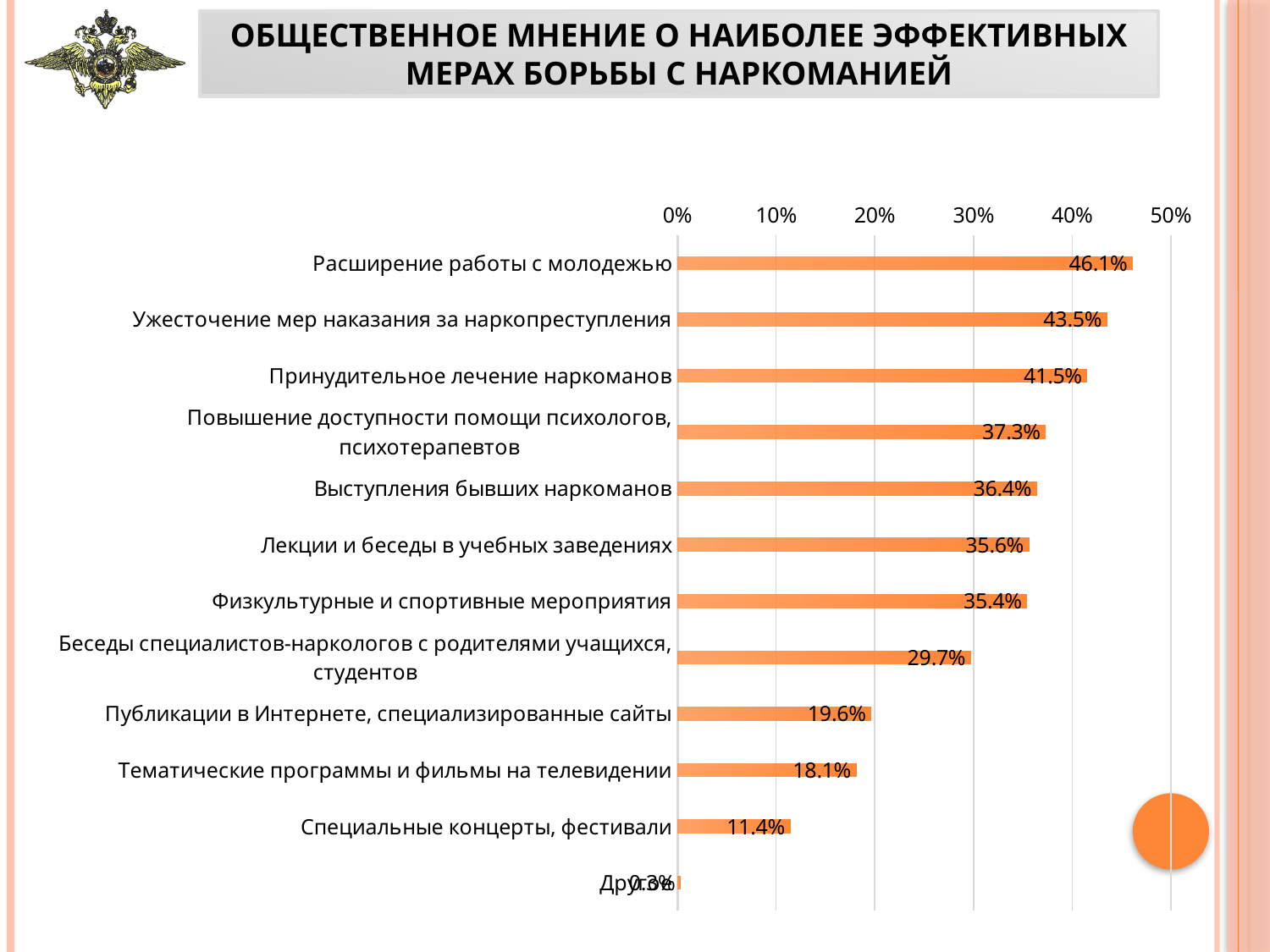
Which is larger: the value for "Выступления бывших наркоманов" or for "Беседы специалистов-наркологов с родителями учащихся, студентов"? Выступления бывших наркоманов Is the value for "Принудительное лечение наркоманов" greater or less than 40%? greater Which category has the highest value? Расширение работы с молодежью How many categories are plotted in the chart? 12 What is the value for "Специальные концерты, фестивали"? 11.4% What is the value for "Беседы специалистов-наркологов с родителями учащихся, студентов"? 29.7% What is the value for "Расширение работы с молодежью"? 46.1% What is the difference between the values for "Публикации в Интернете, специализированные сайты" and "Тематические программы и фильмы на телевидении"? 1.5% What type of chart is shown on the slide? bar chart What is the difference between the values for "Расширение работы с молодежью" and "Ужесточение мер наказания за наркопреступления"? 2.6% What is the title of the slide? ОБЩЕСТВЕННОЕ МНЕНИЕ О НАИБОЛЕЕ ЭФФЕКТИВНЫХ МЕРАХ БОРЬБЫ С НАРКОМАНИЕЙ What is the value for "Принудительное лечение наркоманов"? 41.5%